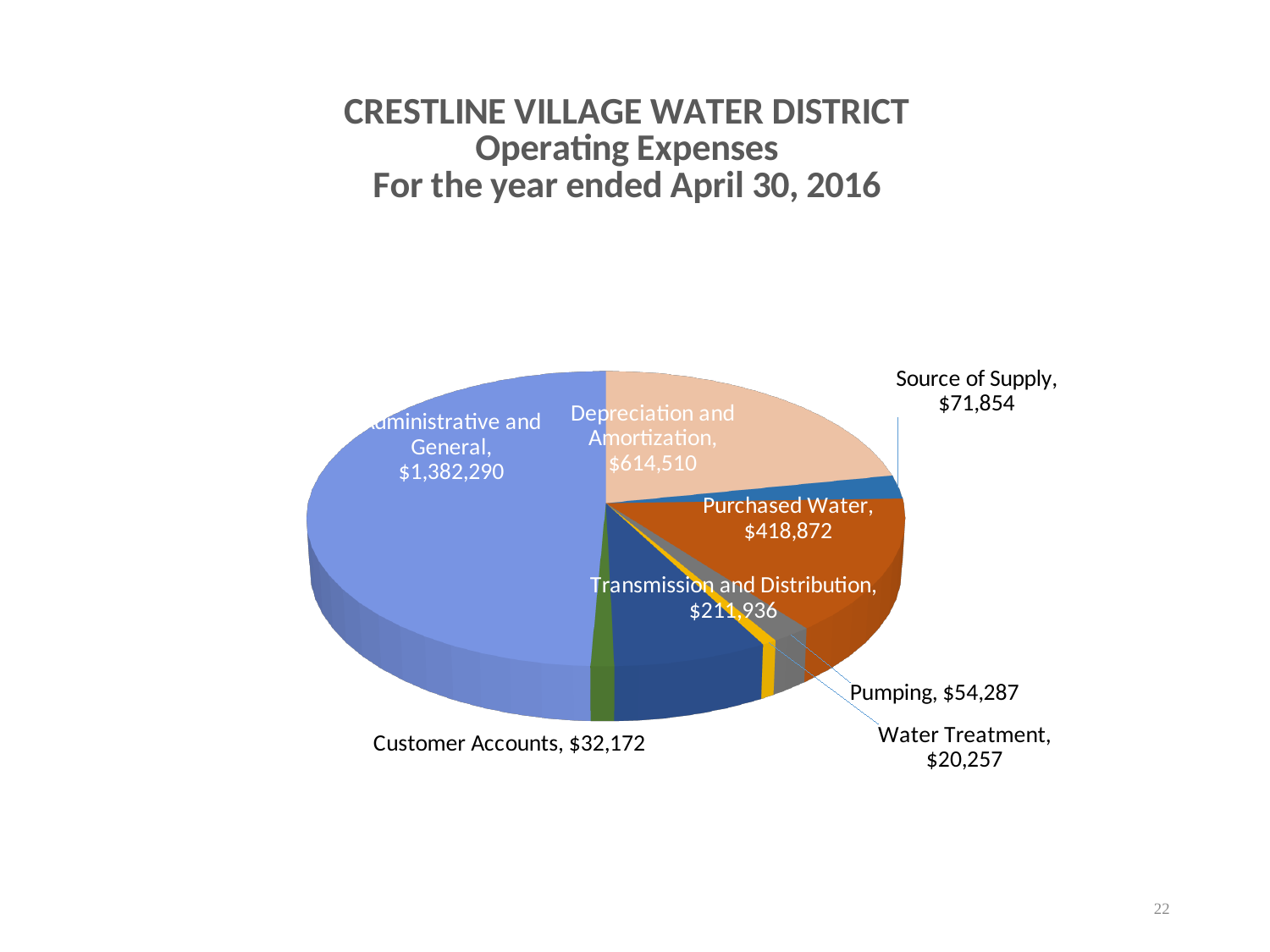
What is the value for Water Treatment? $20,257 How many expense categories are shown in the pie chart? 8 What is the value for Purchased Water? $418,872 Which category has the largest operating expense? Administrative and General What kind of chart is shown on the slide? Pie chart What period does the chart title say the operating expenses cover? For the year ended April 30, 2016 What is the difference between Pumping and Water Treatment? $34,030 Which is larger, Source of Supply or Customer Accounts? Source of Supply Which category has the smallest operating expense? Water Treatment What is the value for Administrative and General? $1,382,290 What is the difference between Depreciation and Amortization and Purchased Water? $195,638 What is the value for Transmission and Distribution? $211,936